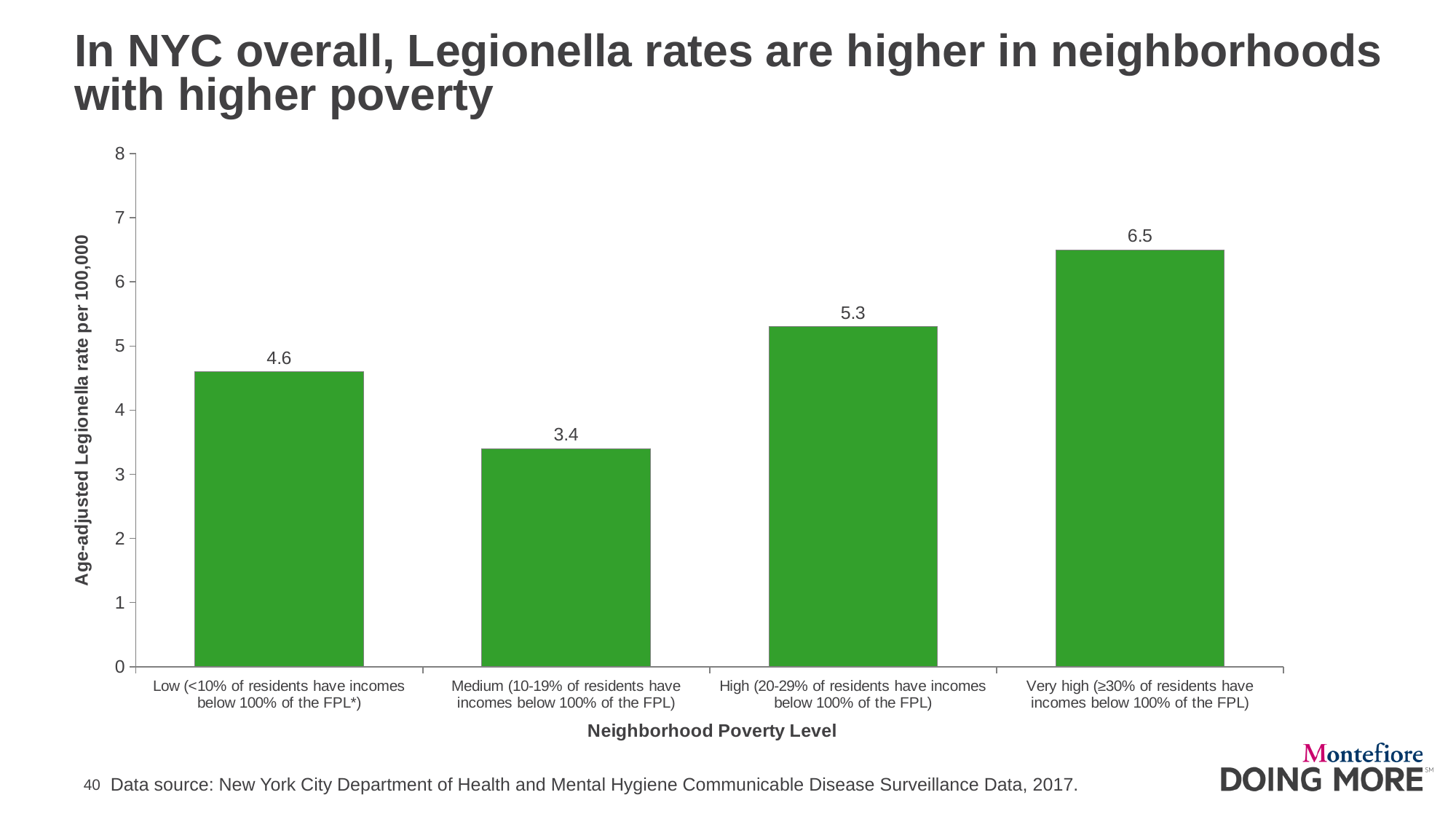
What is the age-adjusted Legionella rate per 100,000 for the Very high poverty neighborhoods? 6.5 What kind of chart is shown on the slide? Bar chart Which neighborhood poverty level has the highest Legionella rate? Very high How many neighborhood poverty level categories are shown in the chart? 4 What is the age-adjusted Legionella rate per 100,000 for the High poverty neighborhoods? 5.3 What is the difference between the Legionella rates for Very high and Low poverty neighborhoods? 1.9 What is the age-adjusted Legionella rate per 100,000 for the Medium poverty neighborhoods? 3.4 Is the Legionella rate for Very high poverty neighborhoods greater or less than 6? greater What is the difference between the Legionella rates for High and Medium poverty neighborhoods? 1.9 Which neighborhood poverty level has the lowest Legionella rate? Medium What is the age-adjusted Legionella rate per 100,000 for the Low poverty neighborhoods? 4.6 Which has a higher Legionella rate, Low or High poverty neighborhoods? High